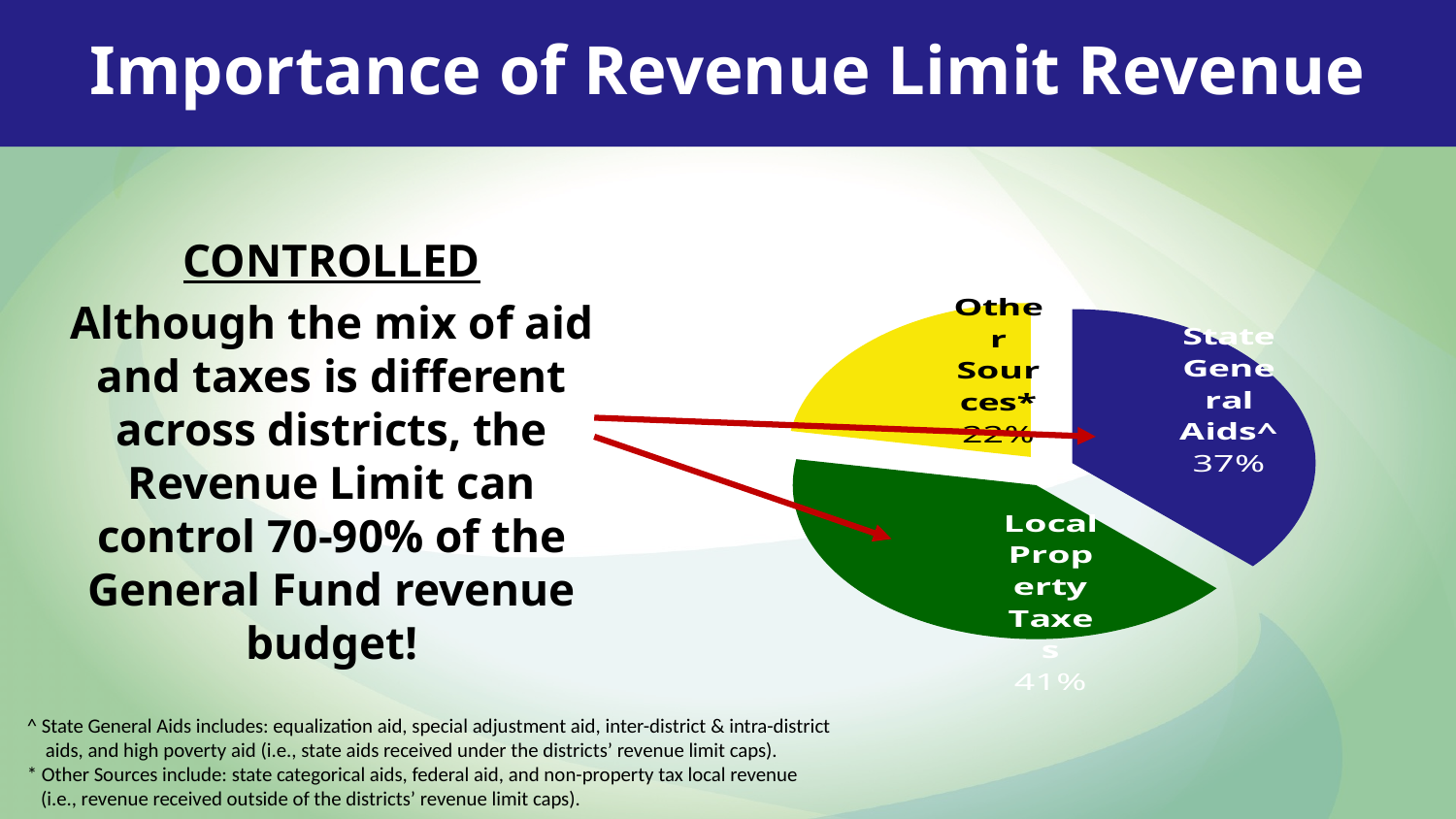
What is the difference in percentage points between State General Aids^ and Other Sources*? 15 What share of the pie is Local Property Taxes? 41% How many slices does the pie chart have? 3 What colour is the Local Property Taxes slice? green What is the difference in percentage points between Local Property Taxes and State General Aids^? 4 Which slice of the pie chart is the smallest? Other Sources* Which slice of the pie chart is the largest? Local Property Taxes What share of the pie is State General Aids^? 37% What kind of chart is shown on the slide? pie chart What share of the pie is Other Sources*? 22% What is the combined share of Local Property Taxes and State General Aids^? 78% Which is larger, the share for State General Aids^ or the share for Other Sources*? State General Aids^